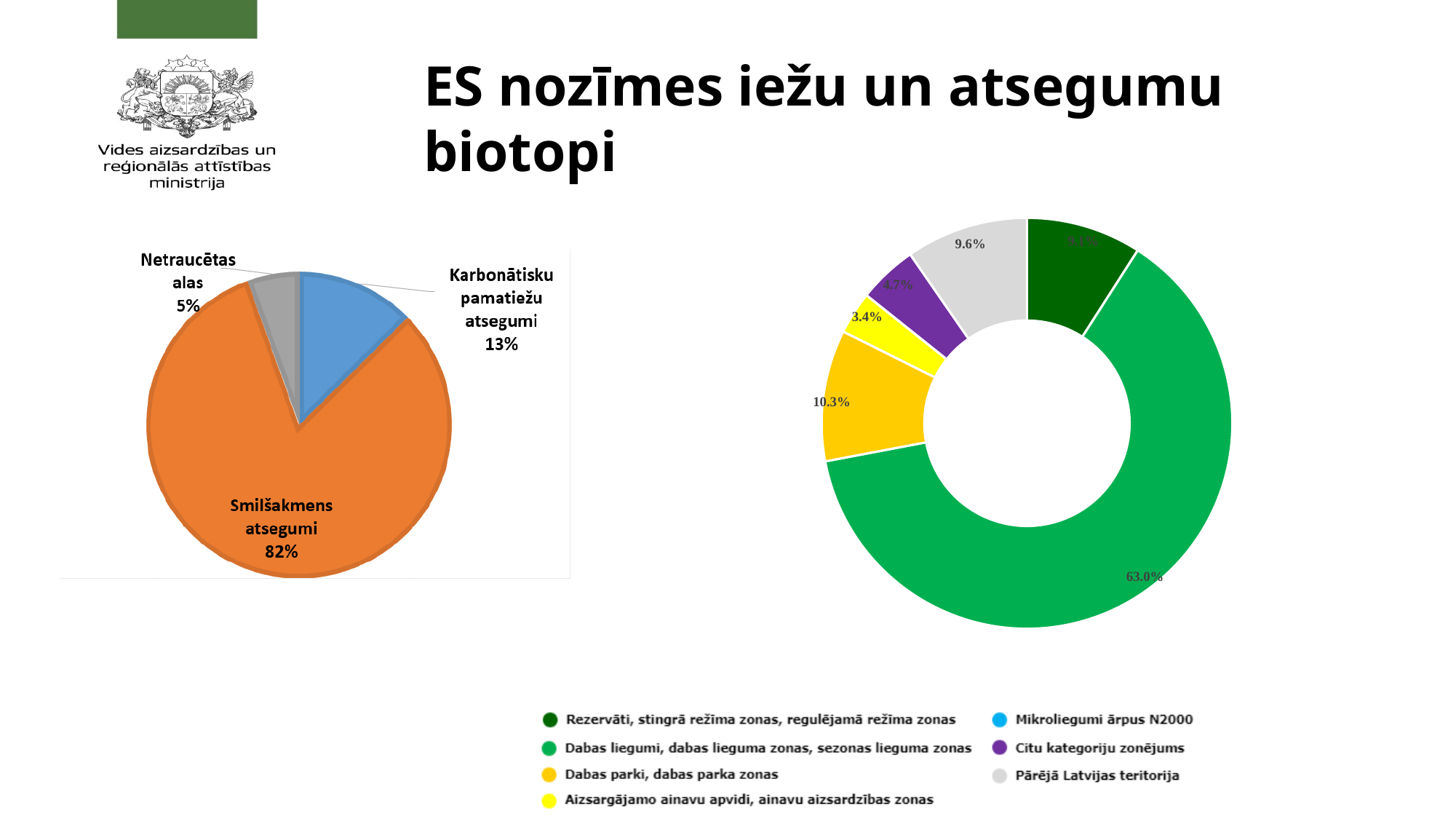
In the pie chart on the left, how many slices are there? 3 In the pie chart on the left, what share is labelled for Netraucētas alas? 5% In the pie chart on the left, which category has the largest slice? Smilšakmens atsegumi In the donut chart on the right, what percentage is labelled on the yellow-orange segment for Dabas parki, dabas parka zonas? 10.3% In the donut chart on the right, what percentage is labelled on the largest (green) segment? 63.0% In the pie chart on the left, what share is labelled for Smilšakmens atsegumi? 82% How many entries does the legend of the donut chart on the right list? 7 In the pie chart on the left, what share is labelled for Karbonātisku pamatiežu atsegumi? 13% In the pie chart on the left, which category has the smallest slice? Netraucētas alas In the donut chart on the right, what percentage is labelled on the light grey segment for Pārējā Latvijas teritorija? 9.6% What kind of chart is shown on the right side of the slide? Donut (pie) chart In the pie chart on the left, what is the difference in percentage points between Smilšakmens atsegumi and Karbonātisku pamatiežu atsegumi? 69 percentage points